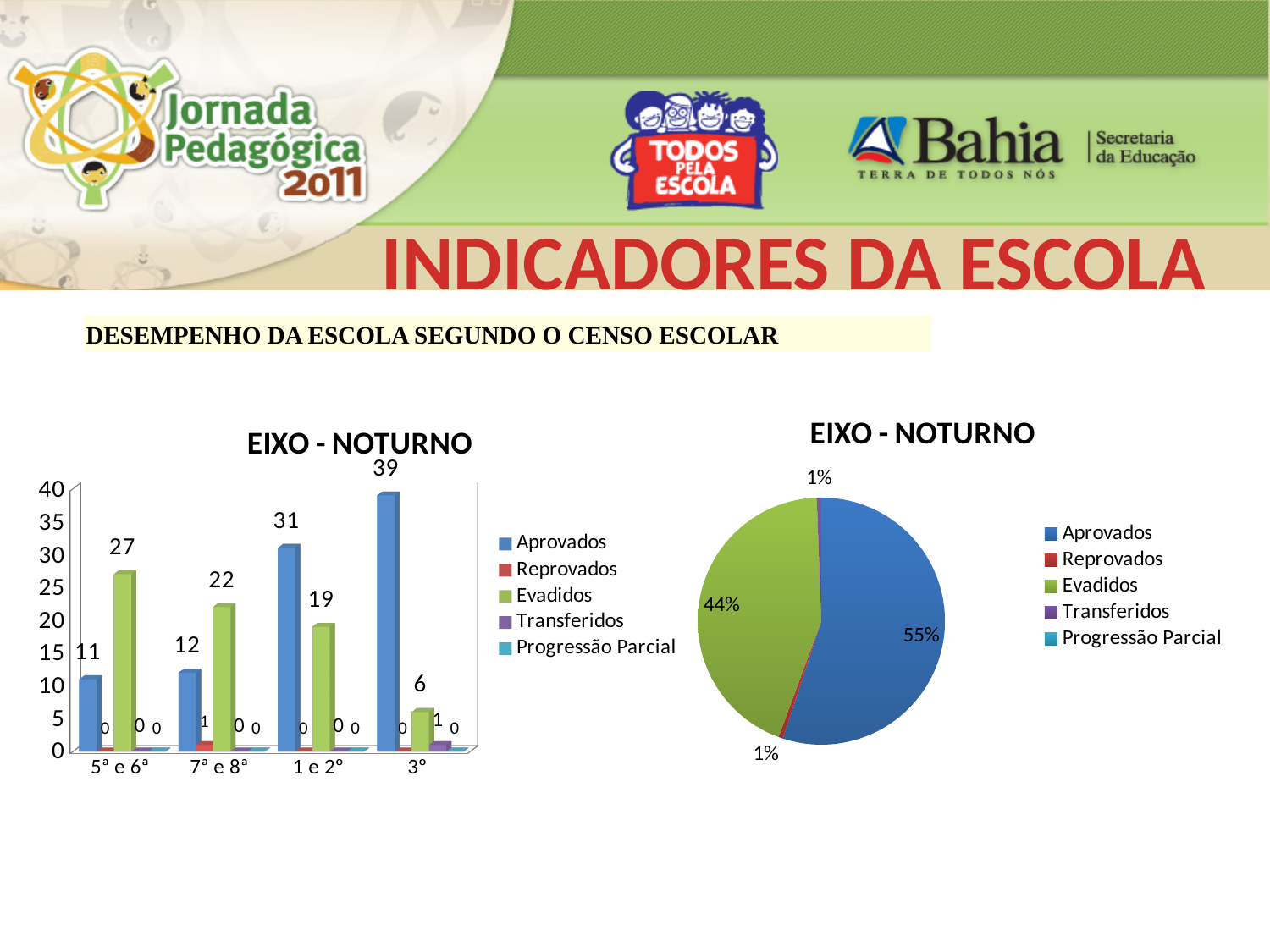
In the bar chart on the left, what is the value for Aprovados in the 1 e 2° category? 31 In the bar chart on the left, which is larger in the 5ª e 6ª category: Aprovados or Evadidos? Evadidos In the bar chart on the left, which category has the highest Aprovados value? 3° What kind of chart is the chart on the right? Pie chart In the pie chart on the right, what share does Aprovados have? 55% In the bar chart on the left, what is the value for Aprovados in the 3° category? 39 In the bar chart on the left, which category has the lowest Evadidos value? 3° How many categories are shown on the x axis of the bar chart on the left? 4 How many series does the legend of the bar chart on the left list? 5 In the bar chart on the left, what is the difference between Aprovados and Evadidos in the 7ª e 8ª category? 10 In the pie chart on the right, what share does Evadidos have? 44% In the bar chart on the left, what is the value for Evadidos in the 5ª e 6ª category? 27